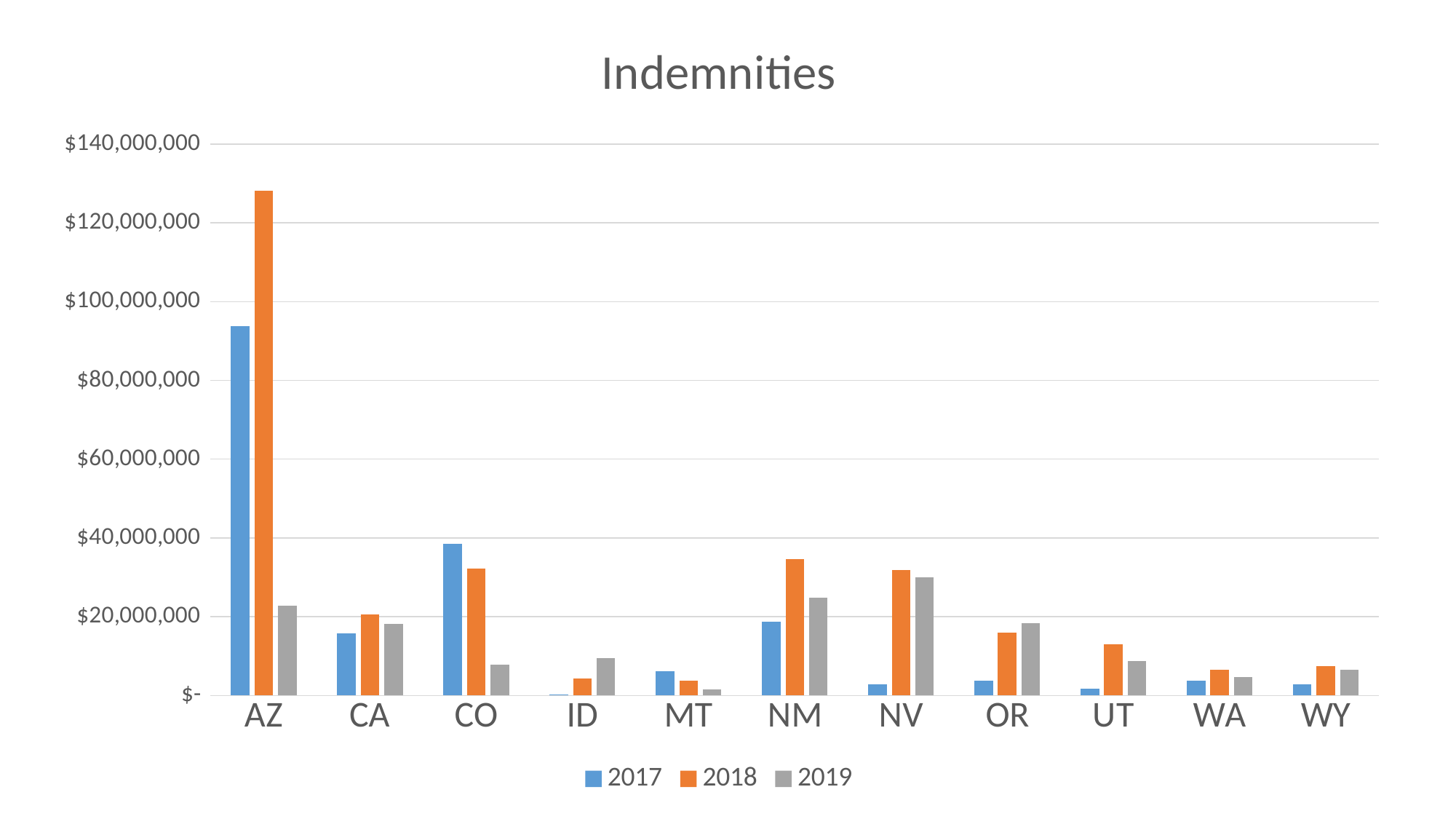
What is the title of the chart? Indemnities How many series does the legend list? 3 For CO, which year has the larger value, 2017 or 2018? 2017 Which state has the lowest 2017 indemnities? ID Which state has the highest 2018 indemnities? AZ Is the 2017 value for AZ greater or less than $100,000,000? less Is the 2018 value for NV greater or less than $20,000,000? greater For NM, which year has the larger value, 2017 or 2018? 2018 How many states are shown on the x axis? 11 Is the 2018 value for AZ greater or less than $120,000,000? greater What kind of chart is shown on the slide? bar chart Do the values for ID rise or fall from 2017 to 2019? rise